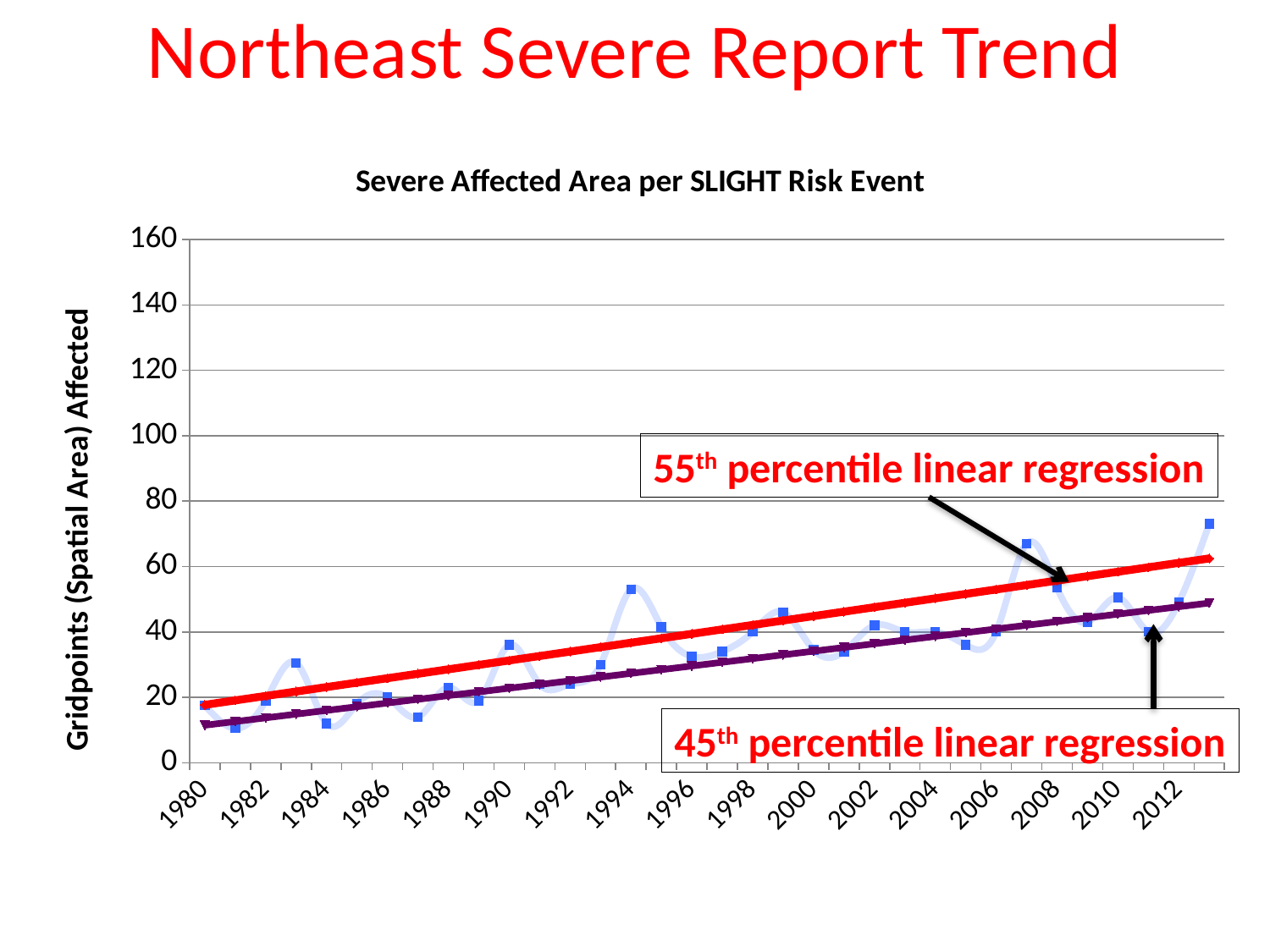
Which year has the highest plotted value? 2013 Which regression line lies higher on the chart, the 55th percentile or the 45th percentile? 55th percentile Is the value for 1981 greater or less than 20? less Is the value for 2007 greater or less than 60? greater Which is larger, the value for 1994 or the value for 1990? 1994 Is the value for 1983 greater or less than 40? less What kind of chart is shown on the slide? line chart What is the title of the chart? Severe Affected Area per SLIGHT Risk Event What is the label of the vertical axis? Gridpoints (Spatial Area) Affected How many year labels are shown on the x axis? 17 Do the two linear regression lines rise or fall from 1980 to 2012? rise